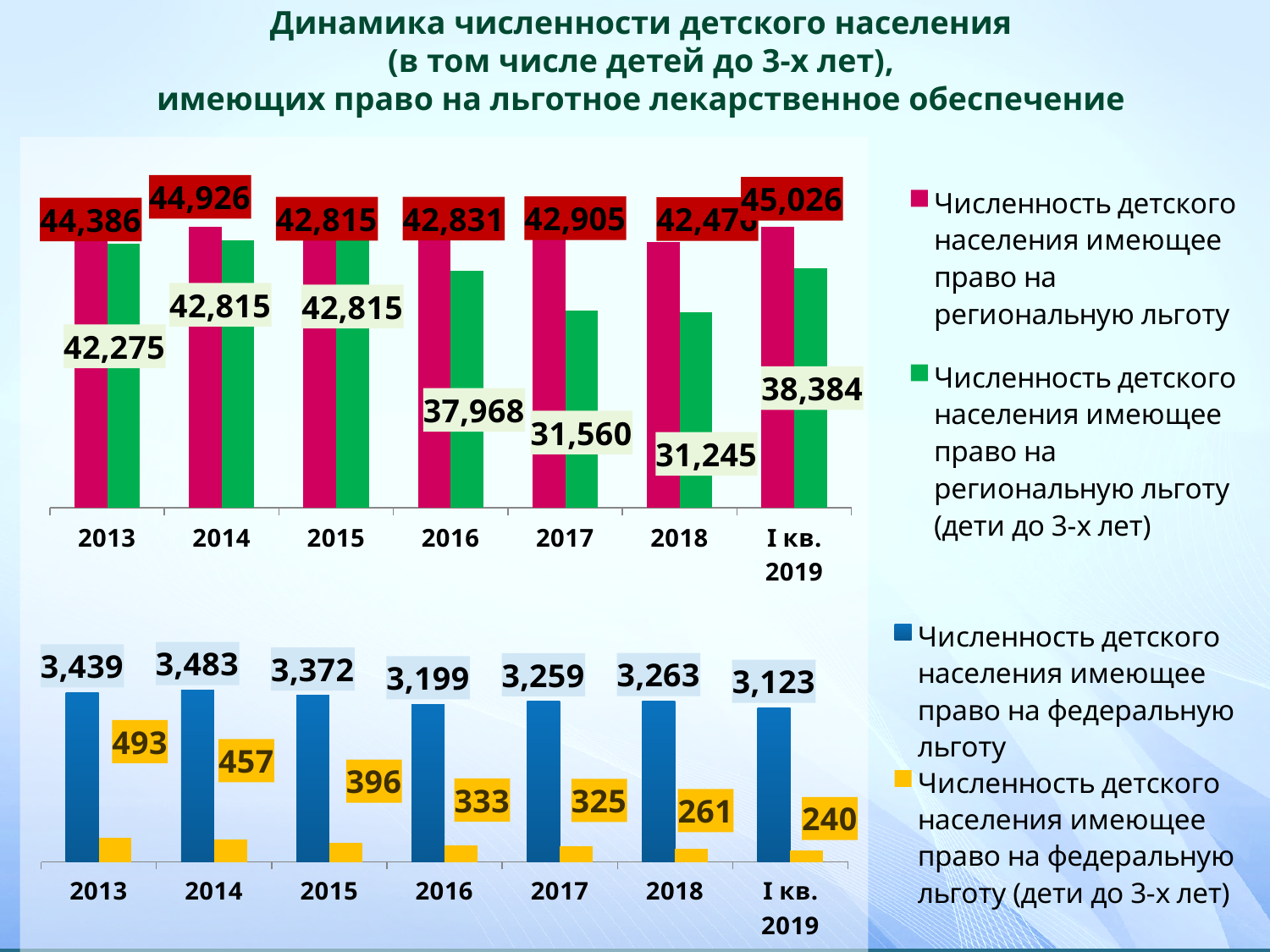
In the top chart, which year has the highest value for the pink (regional benefit) series? I кв. 2019 In the bottom chart, what is the difference between the yellow values for 2013 and I кв. 2019? 253 In the top chart, what is the value for children under 3 (green) in 2017? 31,560 In the top chart, what is the value for the regional benefit series (pink) in 2014? 44,926 In the bottom chart, what is the value for the federal benefit series (blue) in 2016? 3,199 In the bottom chart, do the yellow (children under 3) values rise or fall from 2013 to I кв. 2019? fall In the bottom chart, what is the value for children under 3 (yellow) in 2015? 396 In the top chart, what is the difference between the pink and green values in 2013? 2,111 In the bottom chart, which year has the highest value for the blue (federal benefit) series? 2014 How many categories (time periods) are shown on the x axis of the bottom chart? 7 What kind of chart is the top chart? bar chart In the top chart, which year has the lowest value for the green (children under 3) series? 2018